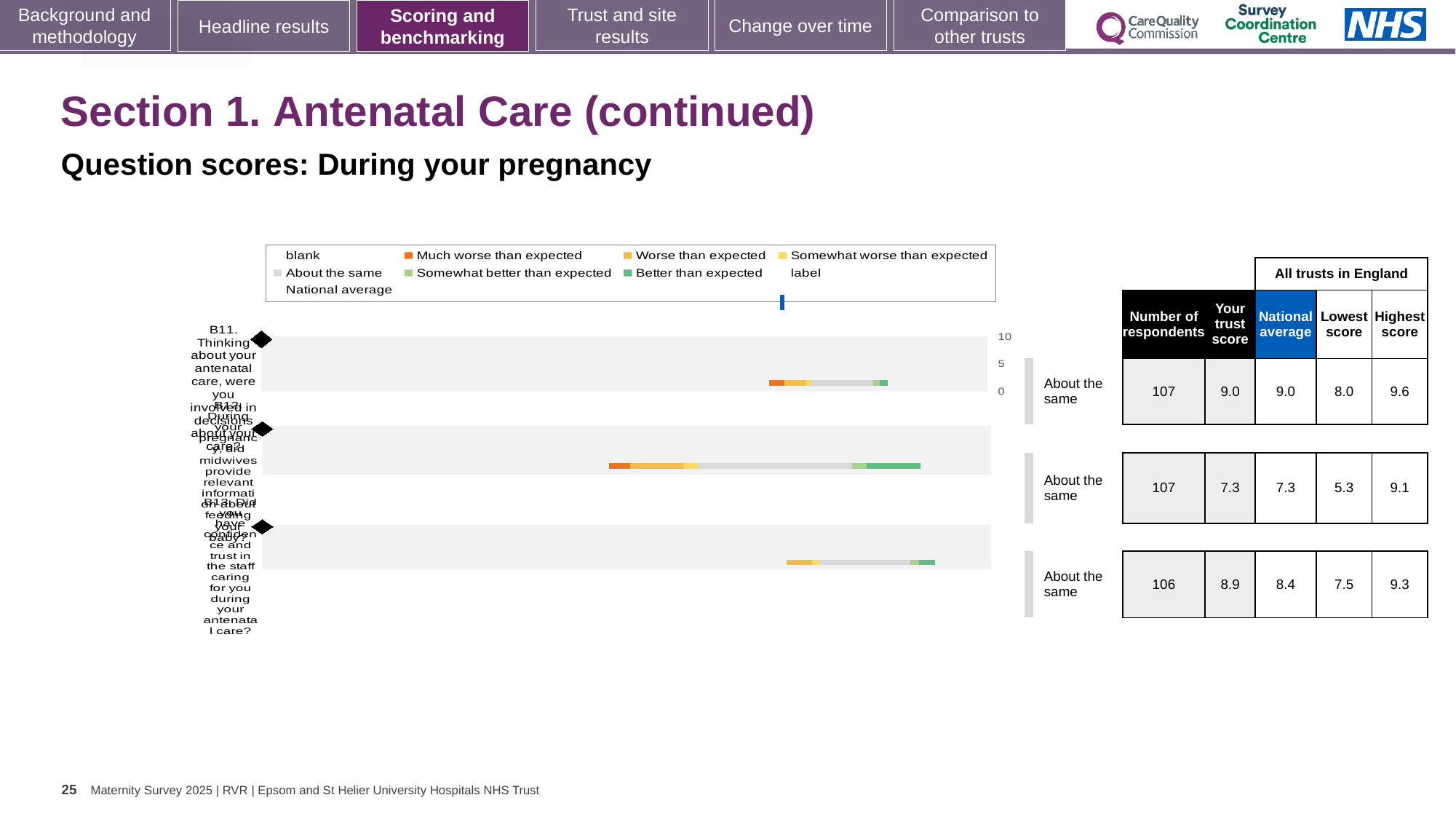
For question B13, what is the difference between the highest score (9.3) and the lowest score (7.5) in the table? 1.8 Which question has the highest 'Your trust score' in the table beside the chart? B11 In the table beside the chart, what is the lowest score among all trusts in England for question B12? 5.3 In the table beside the chart, what is the number of respondents for question B13? 106 What colour does the legend use for 'Much worse than expected'? orange How many questions (categories) are plotted as bars in the chart? 3 What colour does the legend use for 'Better than expected'? green For question B13, which is larger: the trust score or the national average? the trust score In the table beside the chart, what is the 'Your trust score' for question B11? 9.0 How many entries does the chart legend list? 9 What kind of chart is shown on the slide? bar chart In the table beside the chart, what is the national average for question B12? 7.3